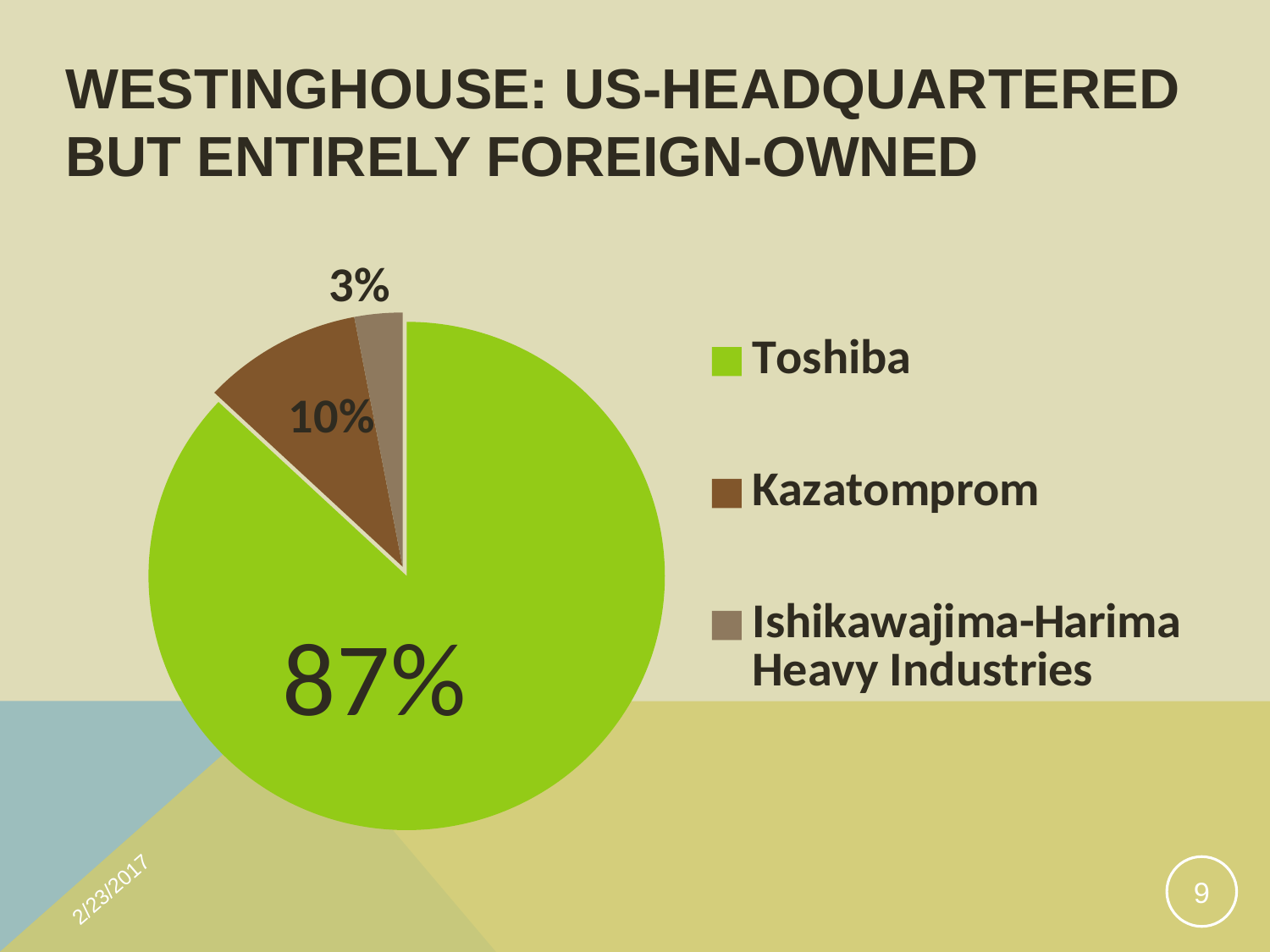
How many slices does the pie chart have? 3 Which owner is represented by the brown slice? Kazatomprom What is the difference in percentage points between Kazatomprom's share and Ishikawajima-Harima Heavy Industries' share? 7 What colour is the slice for Toshiba? Green What is the difference in percentage points between Toshiba's share and Kazatomprom's share? 77 Which owner has the smallest slice of the pie? Ishikawajima-Harima Heavy Industries What kind of chart is shown on the slide? Pie chart What share of the pie does Kazatomprom hold? 10% Which has a larger share, Kazatomprom or Ishikawajima-Harima Heavy Industries? Kazatomprom What share of the pie does Toshiba hold? 87% What share of the pie does Ishikawajima-Harima Heavy Industries hold? 3% Which owner has the largest slice of the pie? Toshiba